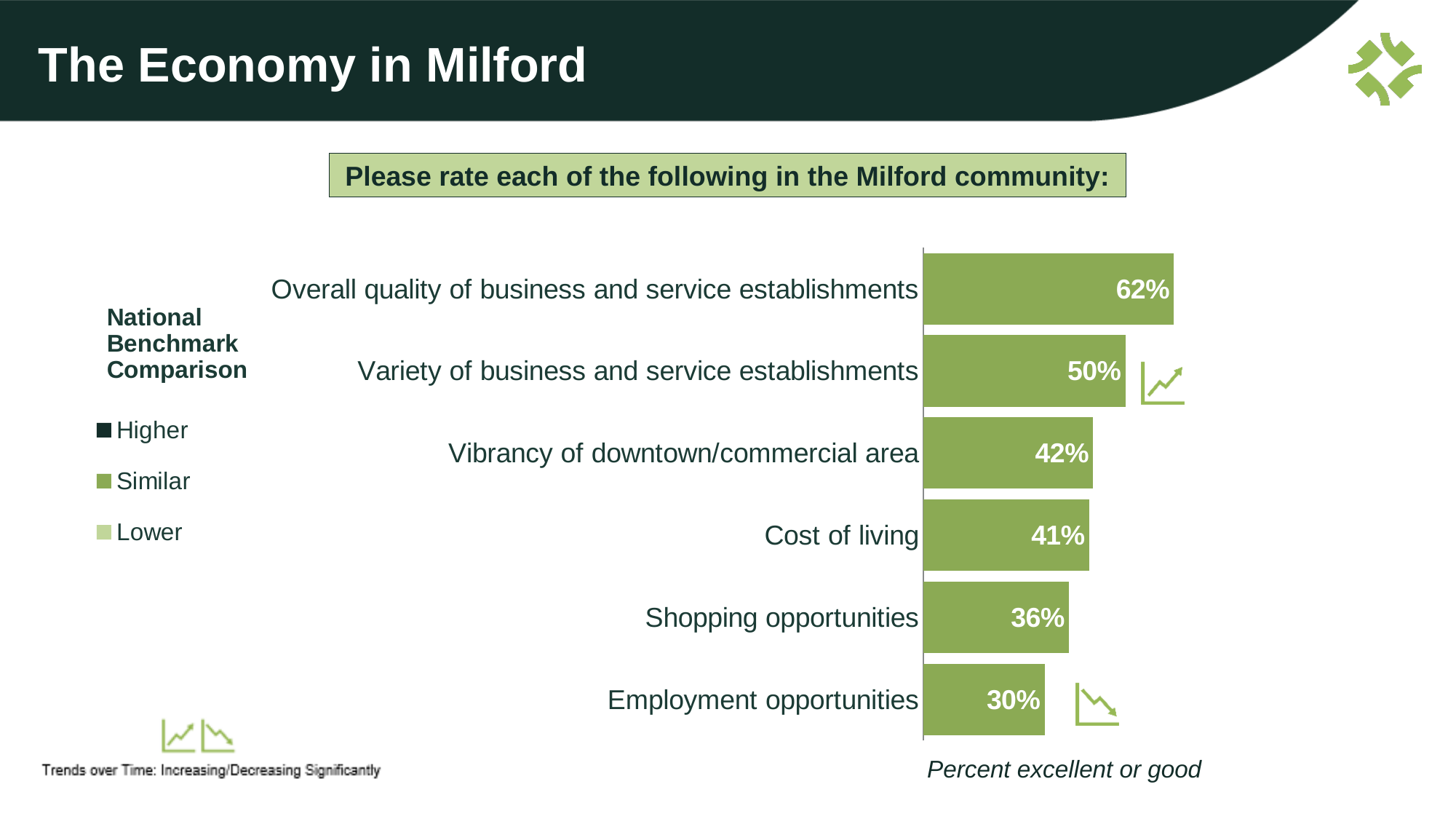
What is the value for Cost of living? 41% Which category is marked with a decreasing trend-over-time icon? Employment opportunities Which category has the lowest percent excellent or good? Employment opportunities What is the value for Employment opportunities? 30% Which is larger, the value for Vibrancy of downtown/commercial area or the value for Shopping opportunities? Vibrancy of downtown/commercial area What percent rated the overall quality of business and service establishments as excellent or good? 62% What does the label below the bars say the values represent? Percent excellent or good What kind of chart is shown on the slide? Bar chart What is the difference between the values for Variety of business and service establishments and Shopping opportunities? 14% Which category has the highest percent excellent or good? Overall quality of business and service establishments How many categories are shown in the chart? 6 How many entries does the National Benchmark Comparison legend list? 3